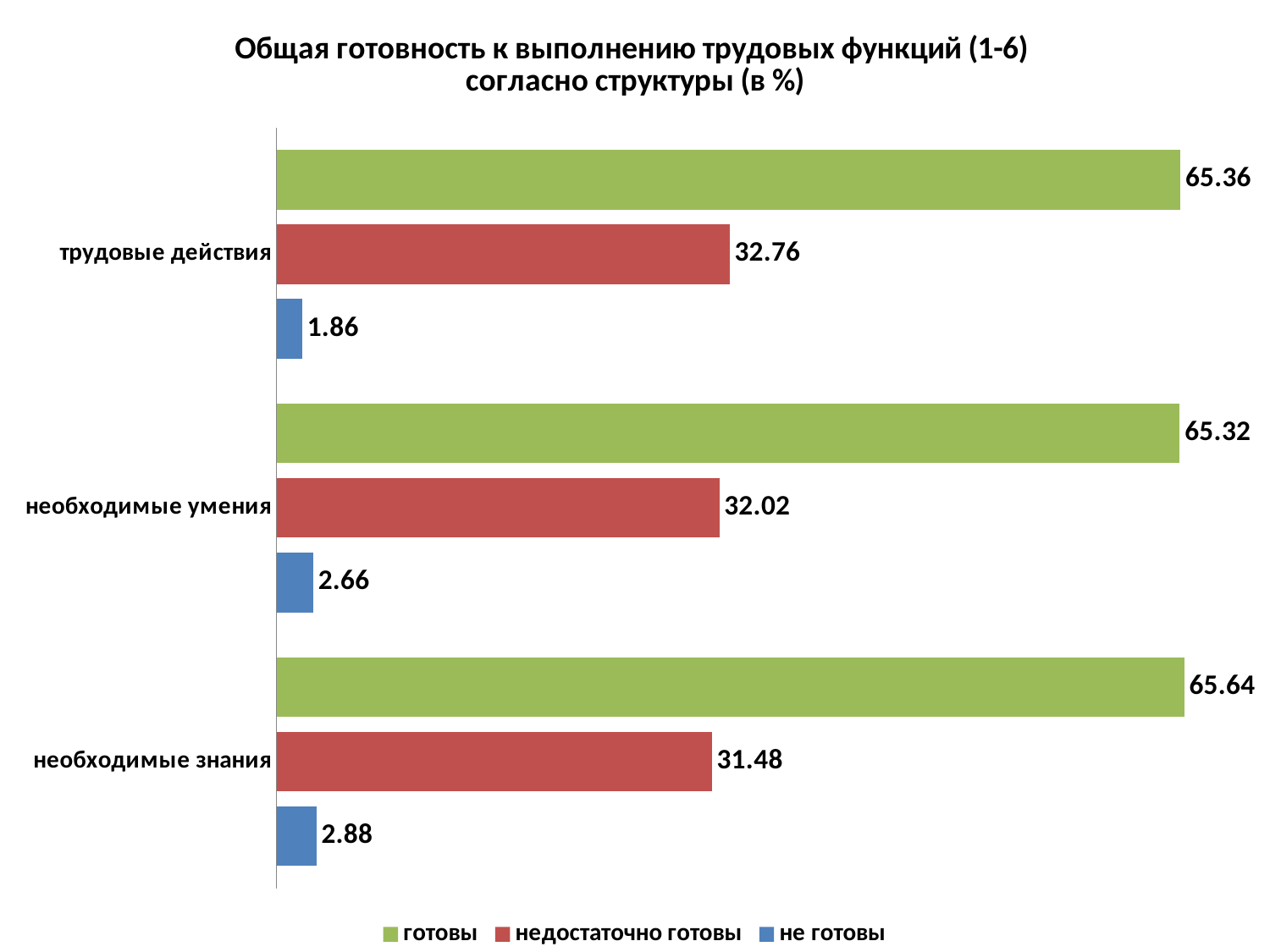
What colour are the bars for the "не готовы" series? blue What is the difference between the "готовы" and "недостаточно готовы" values for "необходимые знания"? 34.16 Which category has the highest value for "недостаточно готовы"? трудовые действия What kind of chart is shown on the slide? bar chart What is the value for "недостаточно готовы" in the "необходимые умения" category? 32.02 What is the value for "не готовы" in the "необходимые знания" category? 2.88 What is the difference between the "недостаточно готовы" values for "трудовые действия" and "необходимые знания"? 1.28 Which is larger: the "не готовы" value for "необходимые умения" or for "необходимые знания"? необходимые знания Which category has the lowest value for "не готовы"? трудовые действия How many categories are shown on the chart? 3 What is the value for "готовы" in the "трудовые действия" category? 65.36 How many series does the legend list? 3